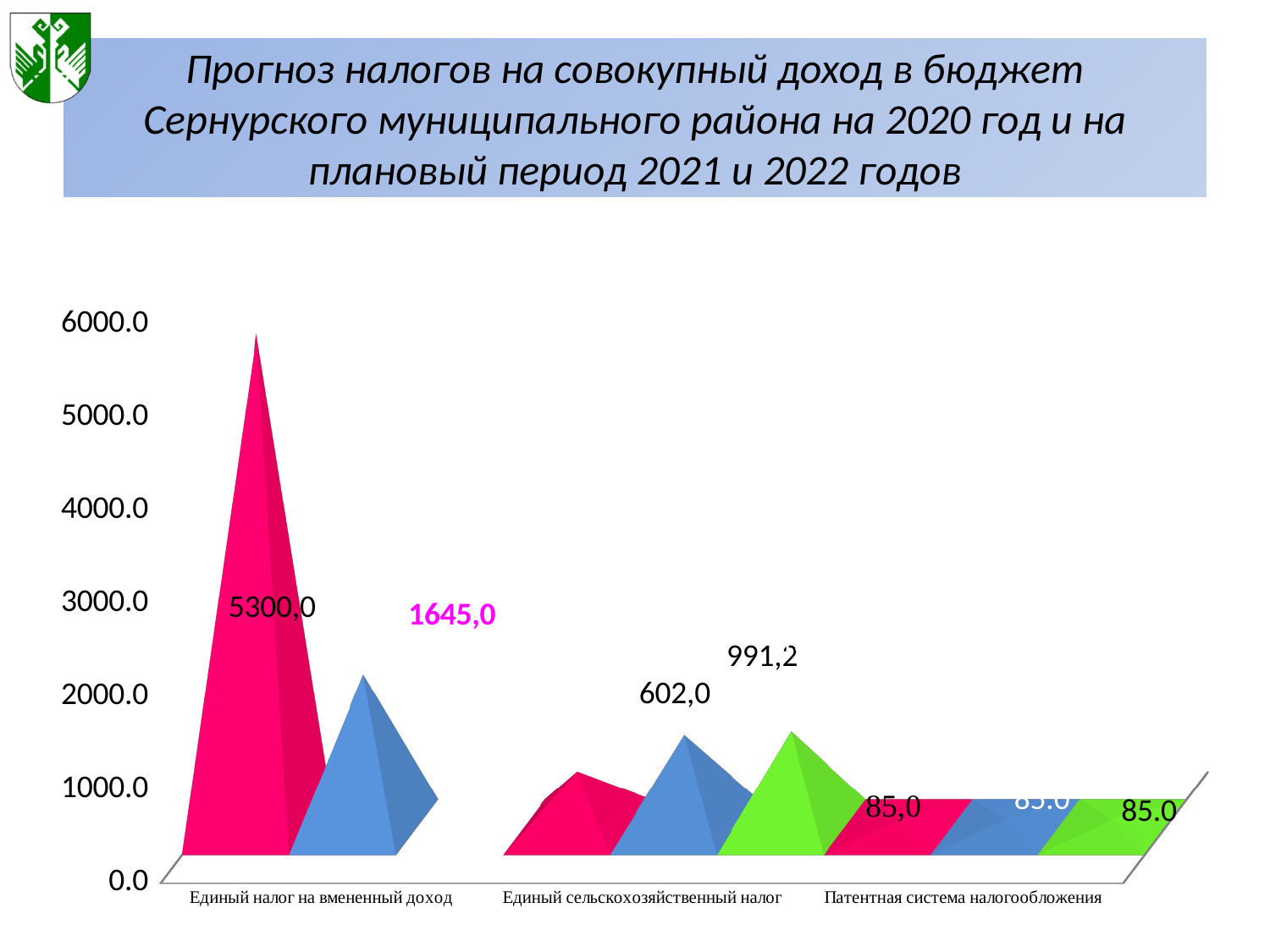
What is the value of the pink bar for Единый сельскохозяйственный налог? 602,0 What is the difference between the blue bar and the pink bar for Единый сельскохозяйственный налог? 389,2 What is the value of the pink bar for Единый налог на вмененный доход? 5300,0 For Единый сельскохозяйственный налог, which is larger: the pink bar or the blue bar? the blue bar What is the value of the pink bar for Патентная система налогообложения? 85,0 What is the value of the blue bar for Единый налог на вмененный доход? 1645,0 Is the value of the pink bar for Единый налог на вмененный доход greater or less than 5000? greater What is the value of the blue bar for Единый сельскохозяйственный налог? 991,2 How many categories are shown on the x axis of the chart? 3 What is the difference between the pink bar and the blue bar for Единый налог на вмененный доход? 3655,0 What kind of chart is shown on the slide? bar chart Which category has the highest value in the chart? Единый налог на вмененный доход